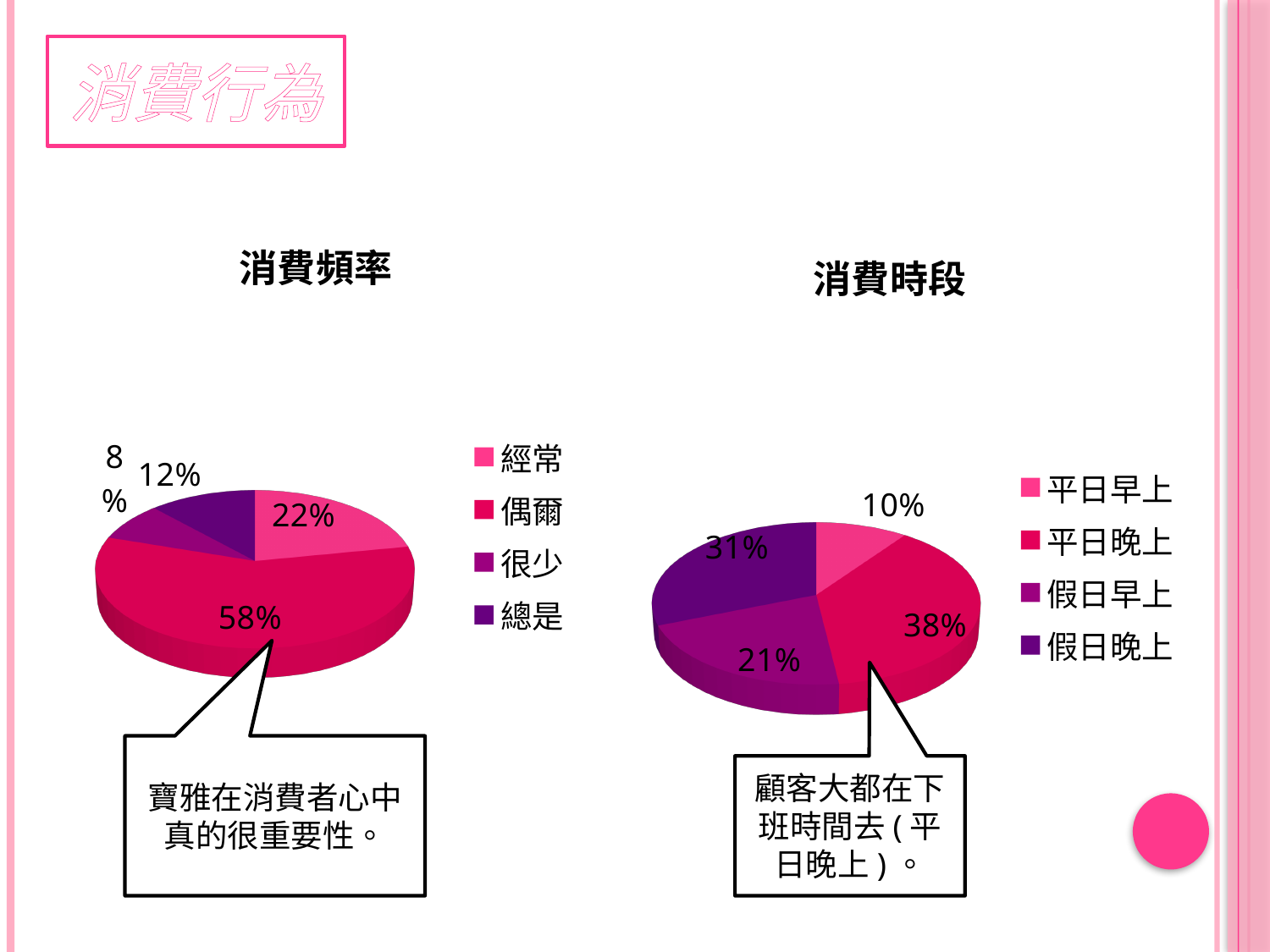
In the 消費頻率 chart, what percentage is shown for 經常? 22% In the 消費時段 chart, which is larger, 假日晚上 or 假日早上? 假日晚上 In the 消費頻率 chart, what is the difference between the shares for 偶爾 and 經常? 36% In the 消費時段 chart, what percentage is shown for 平日晚上? 38% In the 消費時段 chart, what is the difference between the shares for 平日晚上 and 平日早上? 28% In the 消費時段 chart, what percentage is shown for 假日早上? 21% In the 消費頻率 chart, how many categories does the legend list? 4 In the 消費頻率 chart, which category has the largest share? 偶爾 In the 消費頻率 chart, what percentage is shown for 偶爾? 58% What kind of chart is the 消費時段 chart? Pie chart In the 消費時段 chart, which category has the smallest share? 平日早上 In the 消費頻率 chart, which category has the smallest share? 很少